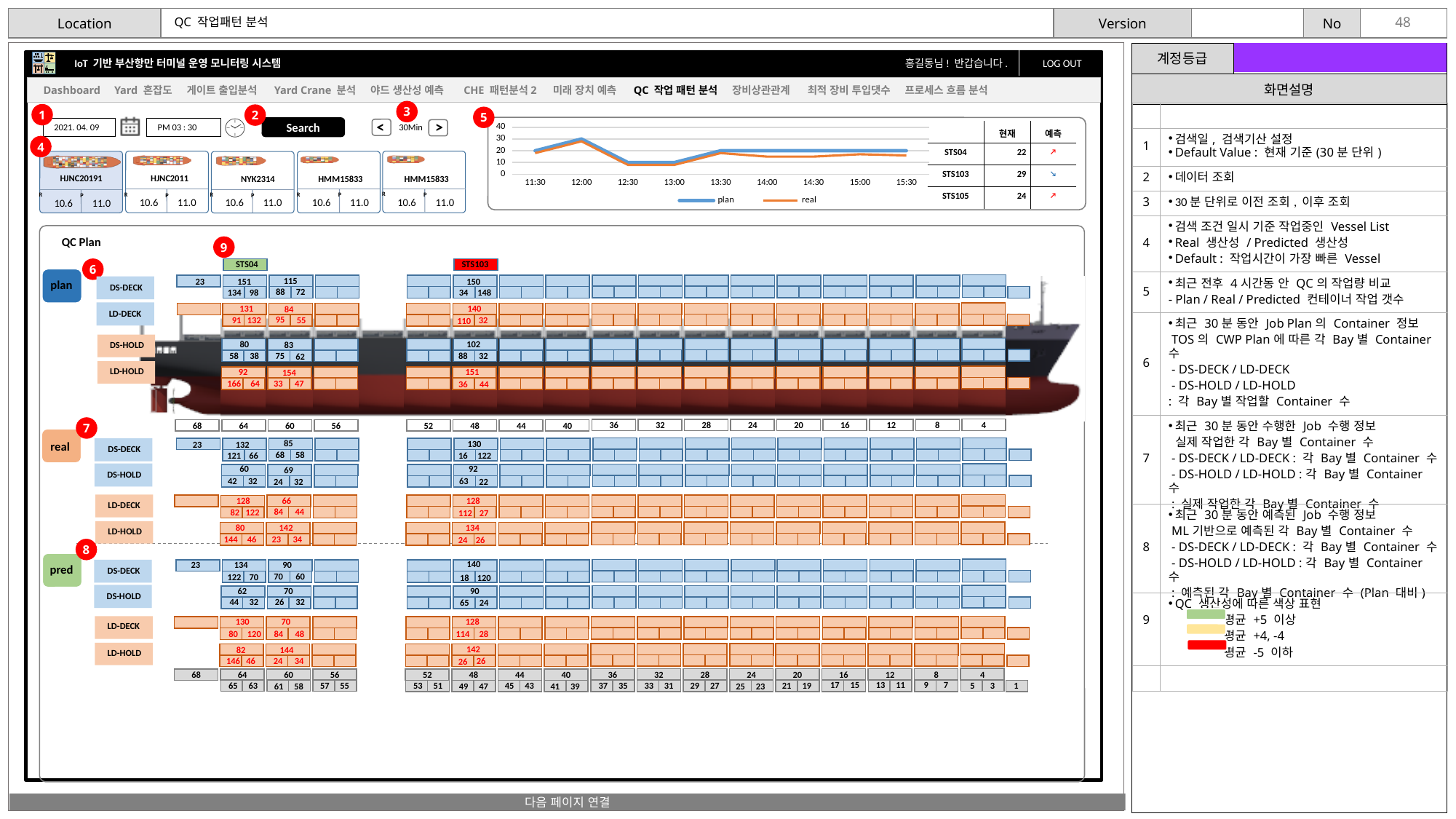
In the table beside the line chart, what is the 현재 value for STS103? 29 In the line chart, is the real value at 13:30 greater or less than 30? less How many series does the legend of the line chart list? 2 In the line chart, is the plan value at 12:00 greater or less than 20? greater What are the two series named in the line chart's legend? plan and real At which time does the plan series reach its highest value in the line chart? 12:00 Which colour represents the real series in the line chart? orange In the line chart, does the plan series rise or fall between 13:00 and 13:30? rise How many time points are labelled on the x axis of the line chart? 9 In the line chart, is the real value at 12:30 greater or less than 20? less What kind of chart is shown in the panel labelled 5 at the top of the slide? line chart In the line chart, does the plan series rise or fall between 12:00 and 12:30? fall